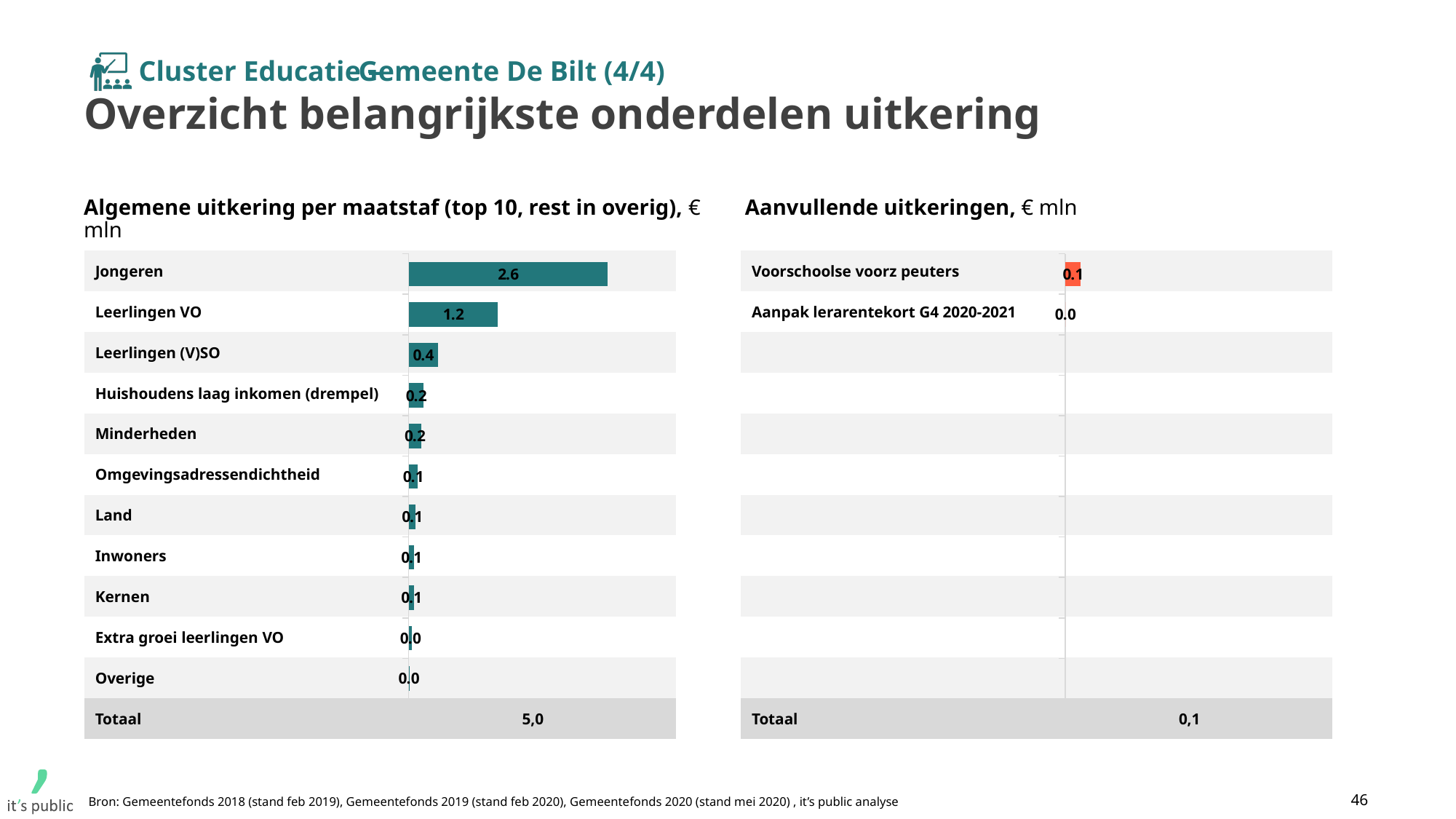
In the left chart 'Algemene uitkering per maatstaf', what is the difference between Jongeren and Leerlingen VO? 1.4 In the right chart 'Aanvullende uitkeringen', what is the value for Aanpak lerarentekort G4 2020-2021? 0.0 What is the Totaal shown under the right chart 'Aanvullende uitkeringen'? 0,1 In the left chart 'Algemene uitkering per maatstaf', which is larger: Leerlingen VO or Leerlingen (V)SO? Leerlingen VO In the left chart 'Algemene uitkering per maatstaf', which category has the highest value? Jongeren What is the Totaal shown under the left chart 'Algemene uitkering per maatstaf'? 5,0 In the right chart 'Aanvullende uitkeringen', what is the value for Voorschoolse voorz peuters? 0.1 How many categories are shown in the left chart 'Algemene uitkering per maatstaf'? 11 In the left chart 'Algemene uitkering per maatstaf', what is the value for Leerlingen (V)SO? 0.4 In the left chart 'Algemene uitkering per maatstaf', what is the value for Leerlingen VO? 1.2 In the left chart 'Algemene uitkering per maatstaf', what is the value for Jongeren? 2.6 What kind of chart is the left chart 'Algemene uitkering per maatstaf'? Bar chart